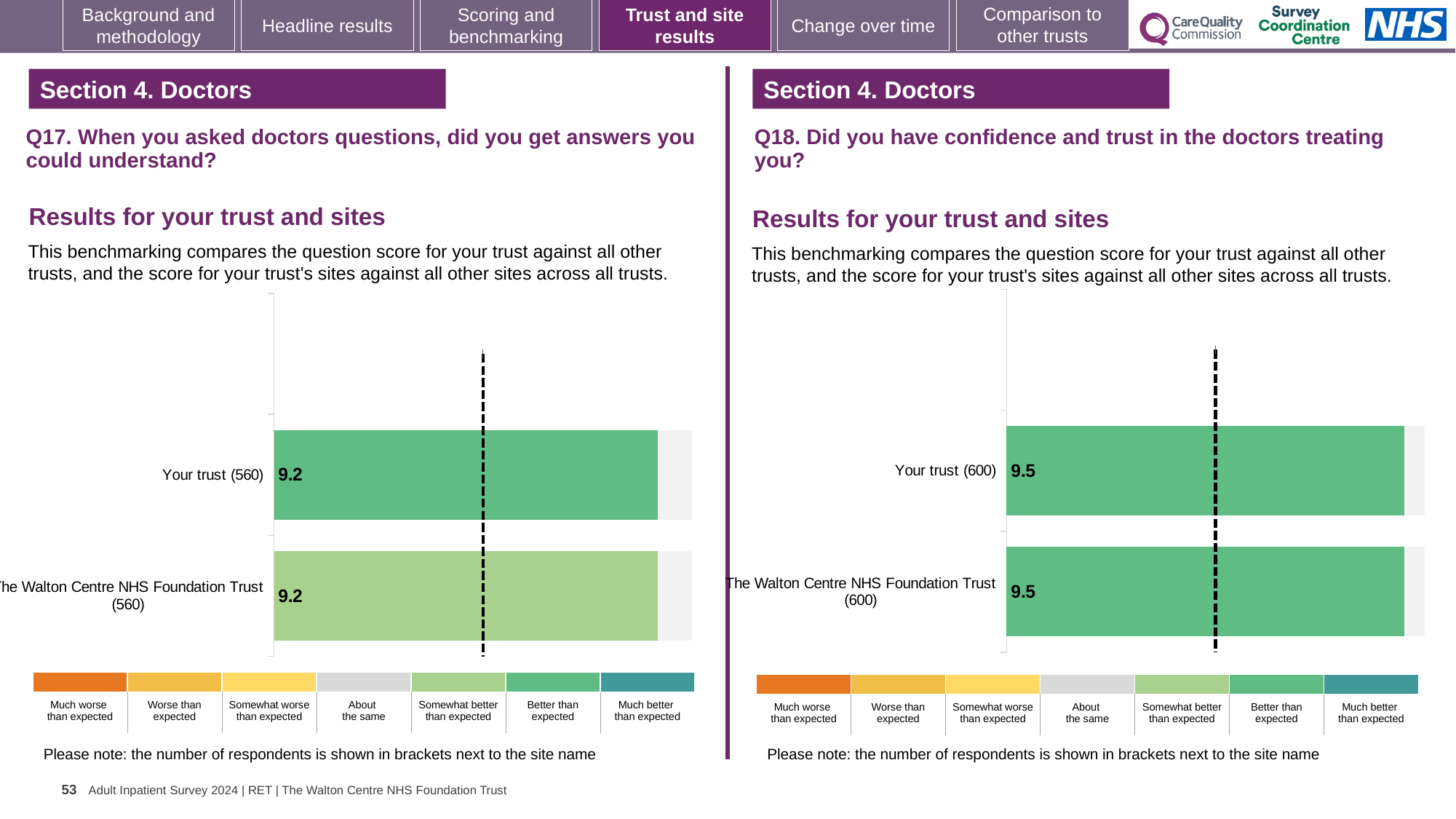
On the Q18 chart (right), which benchmark category does the colour of the bar for Your trust (600) correspond to? Better than expected On the Q17 chart (left), what is the score for Your trust (560)? 9.2 How many respondents are shown in brackets for Your trust on the Q18 chart (right)? 600 How many bars are plotted on the Q17 chart (left)? 2 On the Q18 chart (right), what is the score for The Walton Centre NHS Foundation Trust (600)? 9.5 On the Q17 chart (left), what is the score for The Walton Centre NHS Foundation Trust (560)? 9.2 On the Q17 chart (left), what is the difference between the score for Your trust and the score for The Walton Centre NHS Foundation Trust? 0 On the Q17 chart (left), which benchmark category does the colour of the bar for The Walton Centre NHS Foundation Trust (560) correspond to? Somewhat better than expected What kind of chart is used on the Q17 chart (left)? Bar chart On the Q18 chart (right), what is the difference between the score for Your trust and the score for The Walton Centre NHS Foundation Trust? 0 On the Q18 chart (right), what is the score for Your trust (600)? 9.5 How many bars are plotted on the Q18 chart (right)? 2